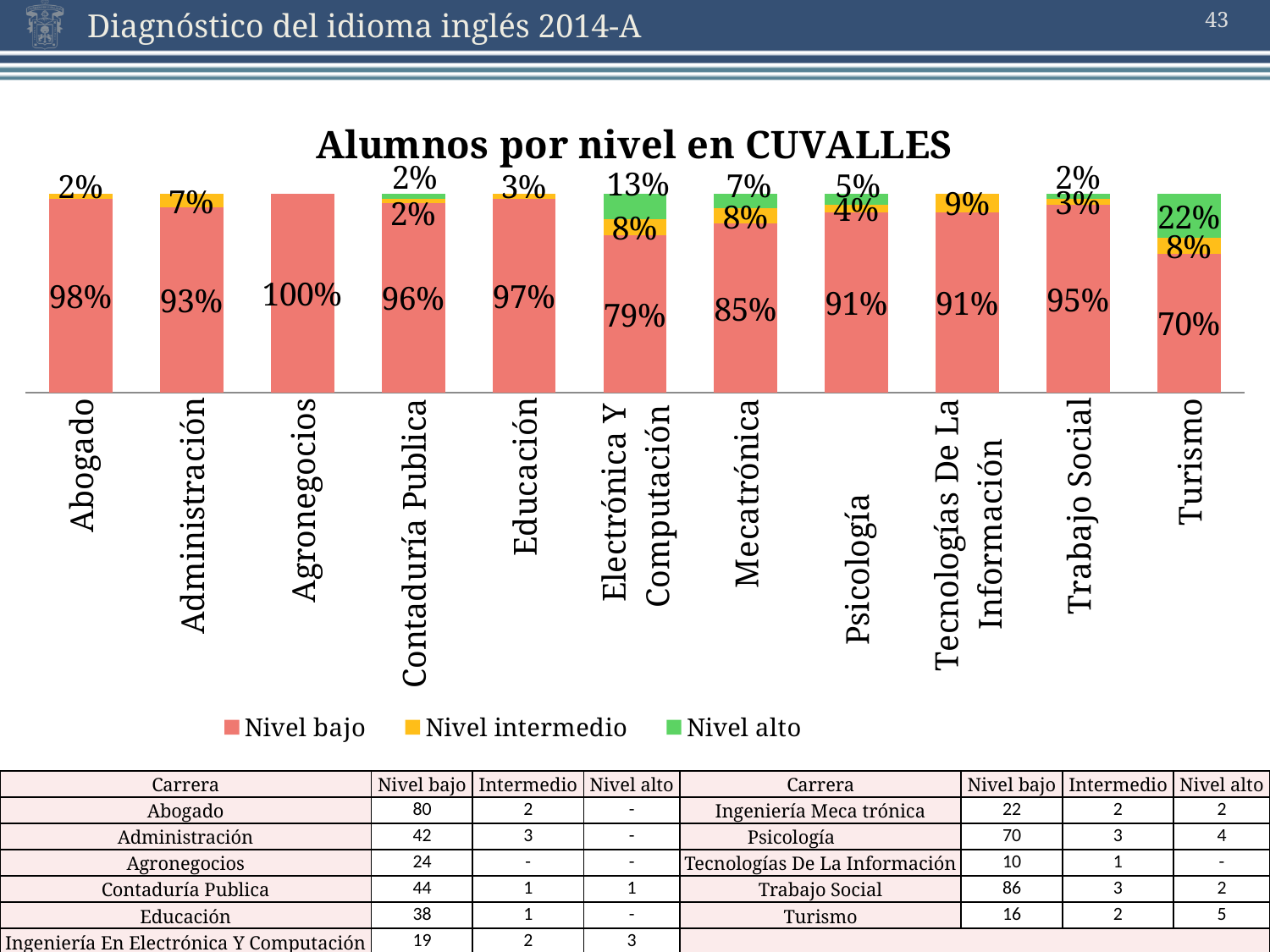
How many series does the chart legend list? 3 Which is larger, the Nivel bajo percentage for Psicología or for Trabajo Social? Trabajo Social What is the difference between the Nivel bajo percentages of Abogado and Mecatrónica? 13% Which career has the lowest Nivel bajo percentage? Turismo What is the Nivel intermedio percentage for Tecnologías De La Información? 9% What is the title of the chart? Alumnos por nivel en CUVALLES What type of chart is shown on the slide? Stacked bar chart What is the Nivel bajo percentage for Turismo? 70% What is the Nivel alto percentage for Electrónica Y Computación? 13% How many careers (categories) are shown on the x axis of the chart? 11 Which career has the highest Nivel alto percentage? Turismo Which career has the highest Nivel bajo percentage? Agronegocios